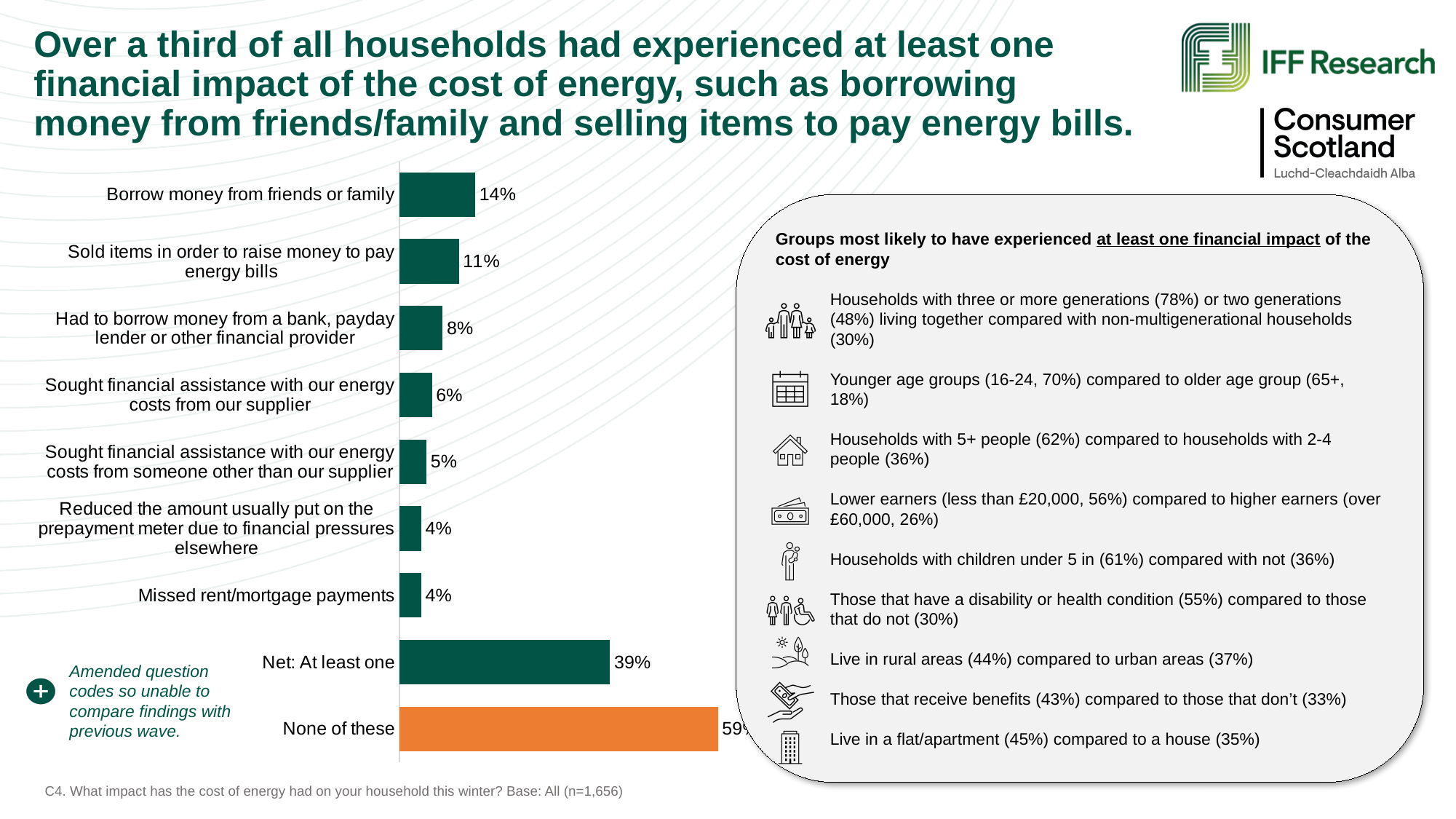
How many categories (bars) are shown in the chart? 9 Which bar in the chart is coloured orange rather than dark green? None of these What is the value for 'Sold items in order to raise money to pay energy bills'? 11% Among the individual financial impacts (excluding the Net and None of these bars), which has the highest value? Borrow money from friends or family What is the value shown for 'Net: At least one'? 39% What percentage had to borrow money from a bank, payday lender or other financial provider? 8% What is the difference between 'Borrow money from friends or family' and 'Sold items in order to raise money to pay energy bills'? 3 percentage points Which bar is longer: 'Net: At least one' or 'None of these'? None of these What percentage of households borrowed money from friends or family? 14% Which is larger: 'Sought financial assistance with our energy costs from our supplier' or 'Sought financial assistance with our energy costs from someone other than our supplier'? Sought financial assistance with our energy costs from our supplier What type of chart is used on the slide? Bar chart What percentage missed rent/mortgage payments? 4%